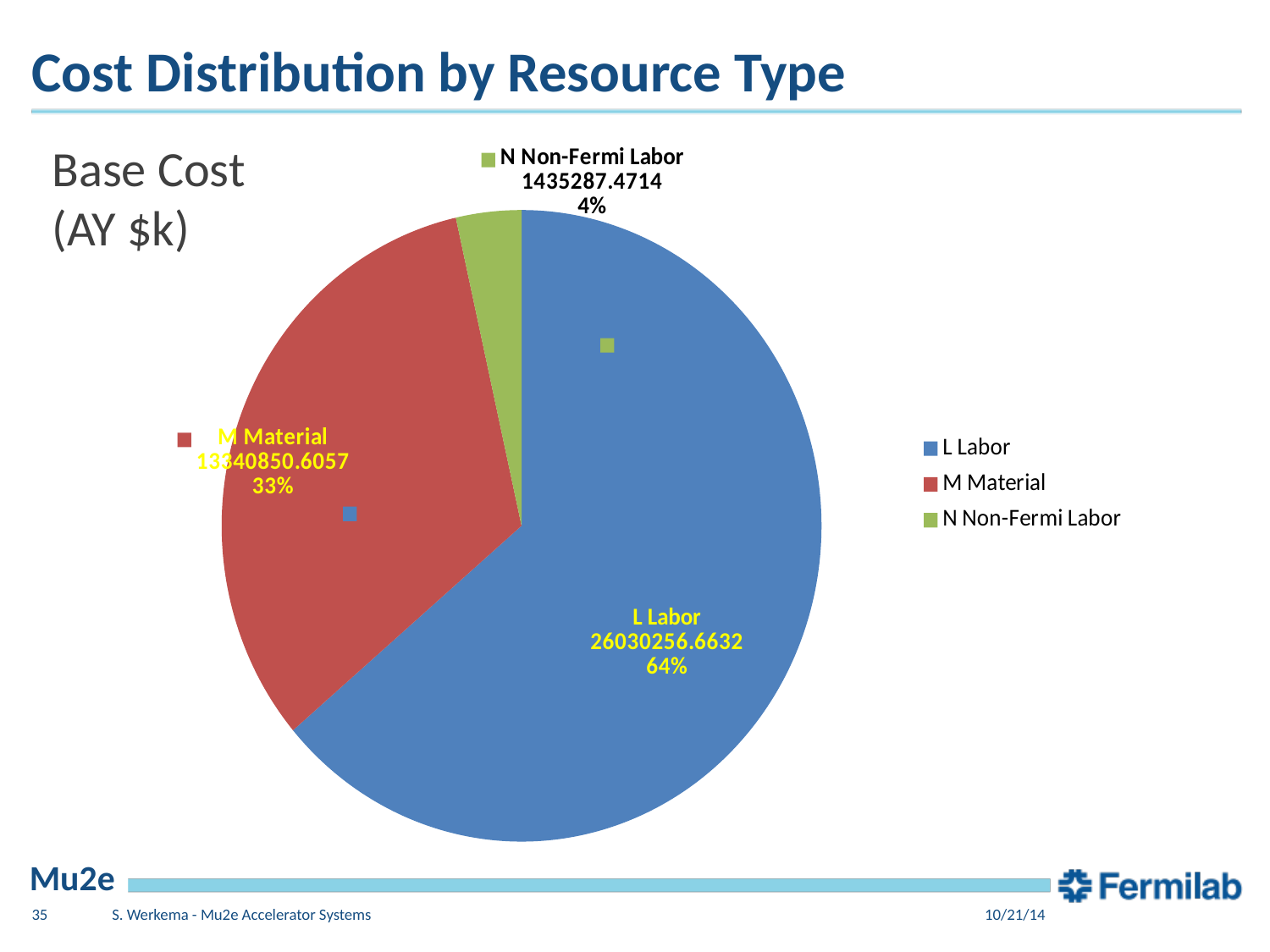
What is the difference between the L Labor value and the M Material value? 12689406.0575 What is the value shown for N Non-Fermi Labor? 1435287.4714 How many slices does the pie chart have? 3 How many entries does the legend list? 3 Which category has the largest slice of the pie? L Labor What share of the pie does M Material represent? 33% What is the value shown for M Material? 13340850.6057 Which category has the smallest slice of the pie? N Non-Fermi Labor What type of chart is shown on the slide? pie chart What is the title of the chart? Base Cost (AY $k) What is the value shown for L Labor? 26030256.6632 What share of the pie does L Labor represent? 64%